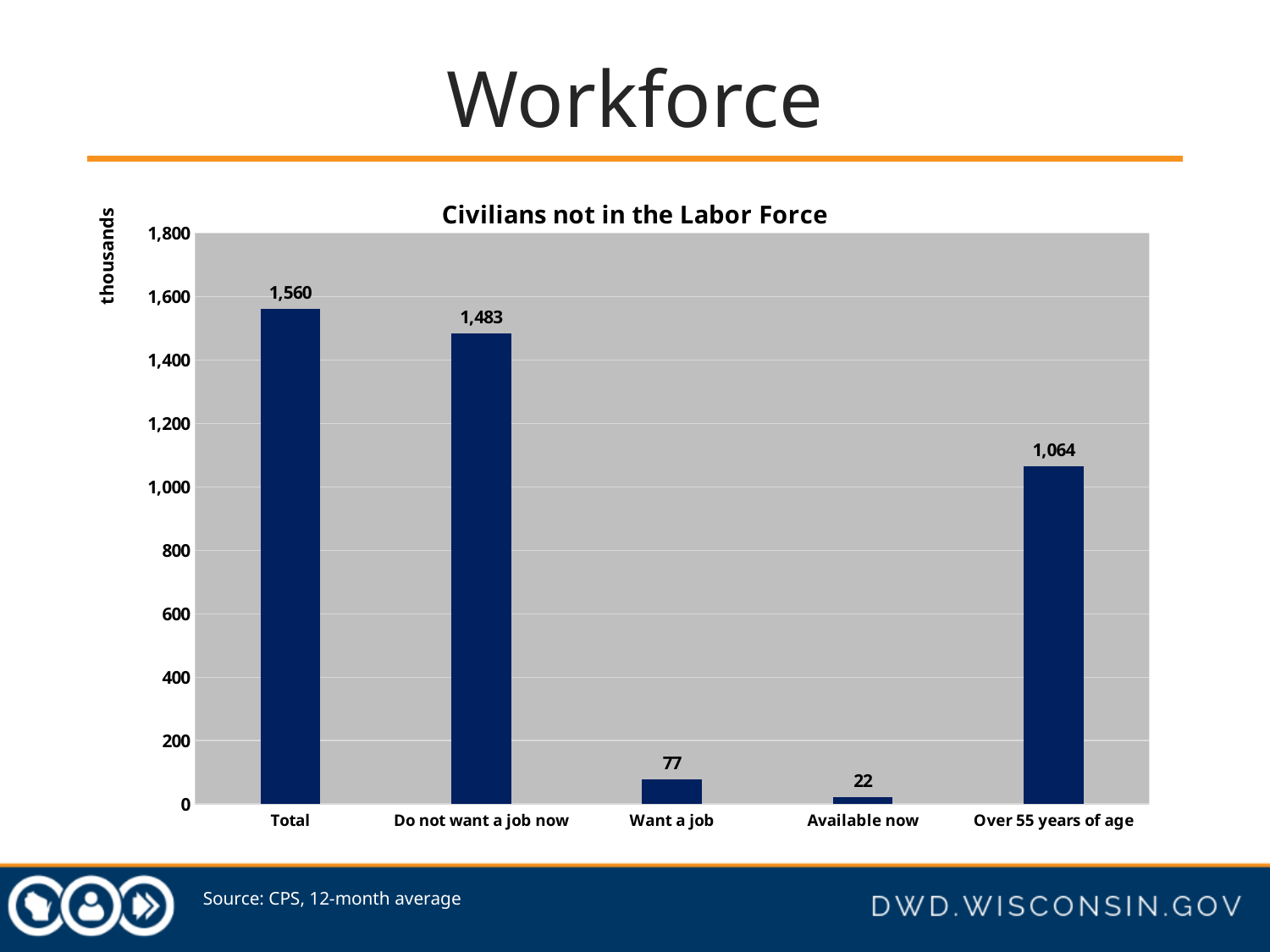
What is the value for Available now? 22 What is the difference between Want a job and Available now? 55 What is the value for Total in the Civilians not in the Labor Force chart? 1,560 How many categories are shown on the x axis? 5 Which category has the lowest value? Available now Which category has the highest value? Total What unit is given on the vertical axis label? thousands What is the value for Do not want a job now? 1,483 What is the value for Over 55 years of age? 1,064 What kind of chart is shown on the slide? Bar chart Which is larger, Do not want a job now or Over 55 years of age? Do not want a job now What is the difference between Total and Do not want a job now? 77